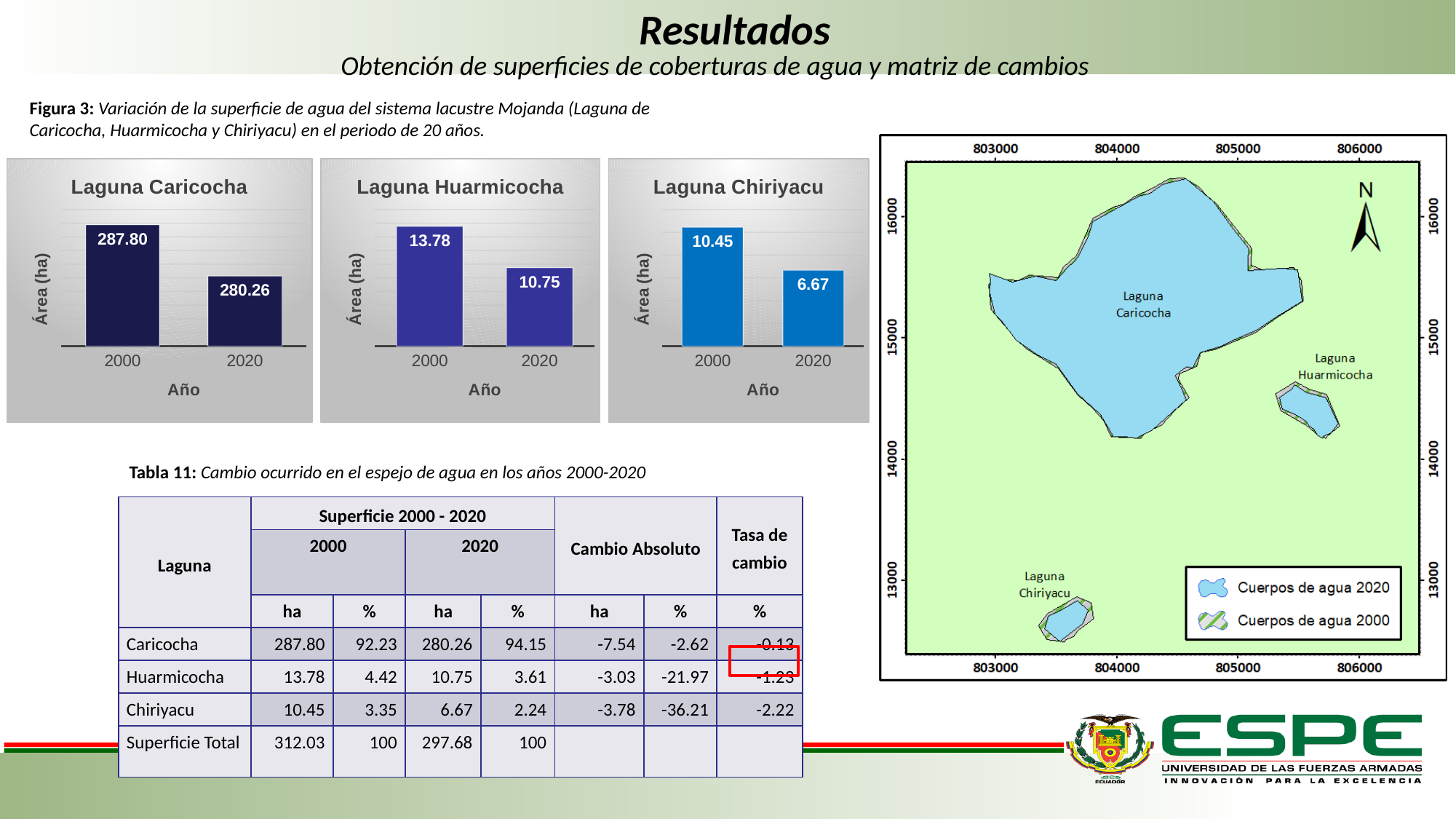
In the Laguna Huarmicocha chart, what is the area for 2000? 13.78 How many bars are shown in the Laguna Huarmicocha chart? 2 In the Laguna Caricocha chart, by how much did the area decrease from 2000 to 2020? 7.54 In the Laguna Caricocha chart, what is the area for 2000? 287.80 In the Laguna Chiriyacu chart, do the values rise or fall from 2000 to 2020? fall In the Laguna Chiriyacu chart, what is the difference between the 2000 and 2020 values? 3.78 In the Laguna Huarmicocha chart, what is the area for 2020? 10.75 In the Laguna Huarmicocha chart, which year has the higher area? 2000 What kind of chart is the Laguna Caricocha chart? bar chart In the Laguna Chiriyacu chart, what is the area for 2020? 6.67 In the Laguna Caricocha chart, what is the area for 2020? 280.26 In the Laguna Chiriyacu chart, what is the area for 2000? 10.45